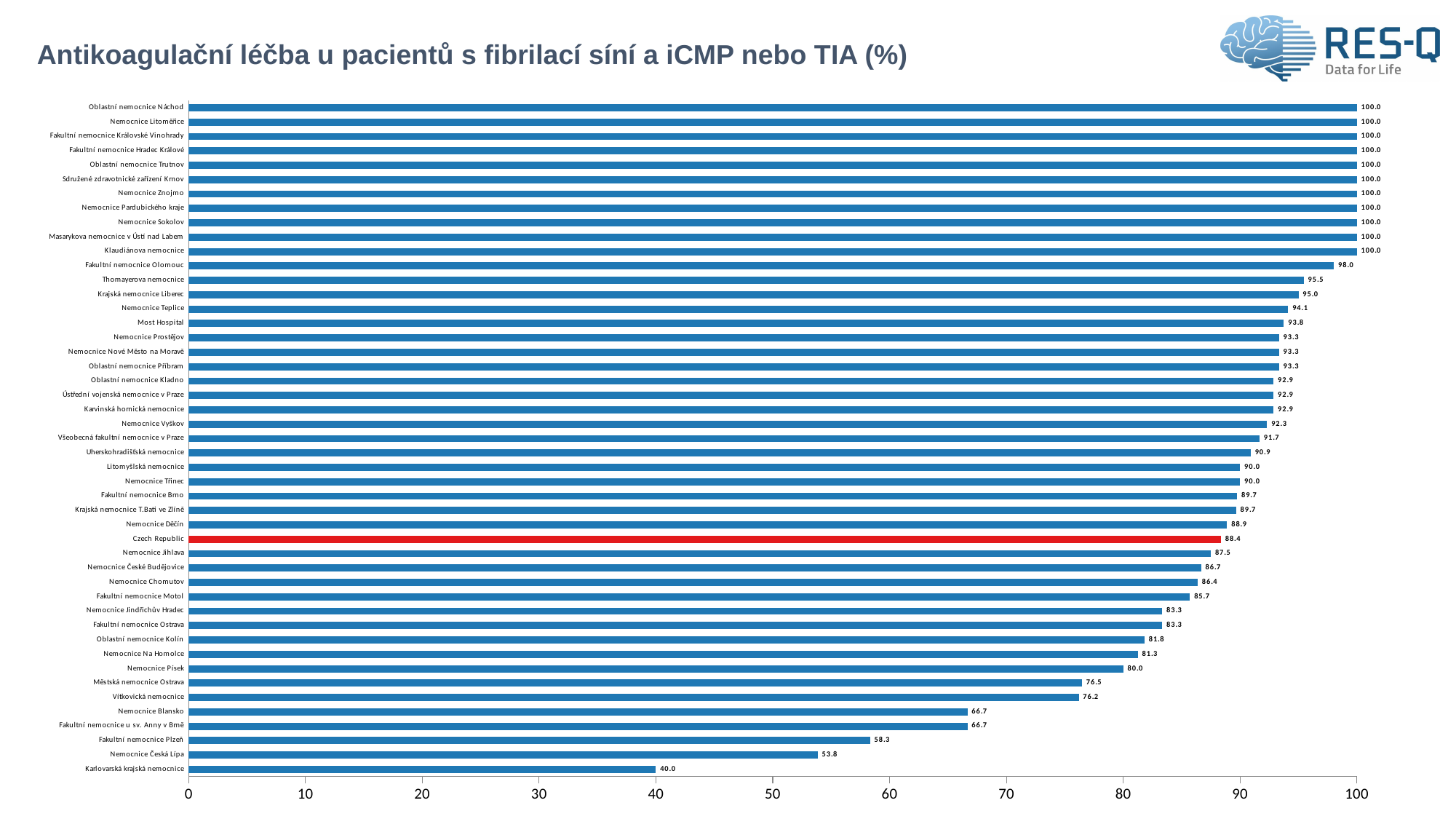
Which is larger, the value for Nemocnice Písek or the value for Nemocnice Blansko? Nemocnice Písek Is the value for Vítkovická nemocnice greater or less than 80? less Which hospital has the lowest value? Karlovarská krajská nemocnice What is the difference between the values for Thomayerova nemocnice and Fakultní nemocnice Plzeň? 37.2 Which bar is highlighted in red? Czech Republic What is the value for Czech Republic? 88.4 What is the value for Fakultní nemocnice Motol? 85.7 How many hospitals/categories are shown on the chart? 47 What is the difference between the values for Czech Republic and Karlovarská krajská nemocnice? 48.4 What is the value for Nemocnice Česká Lípa? 53.8 What is the value for Fakultní nemocnice Olomouc? 98.0 What kind of chart is shown on the slide? bar chart